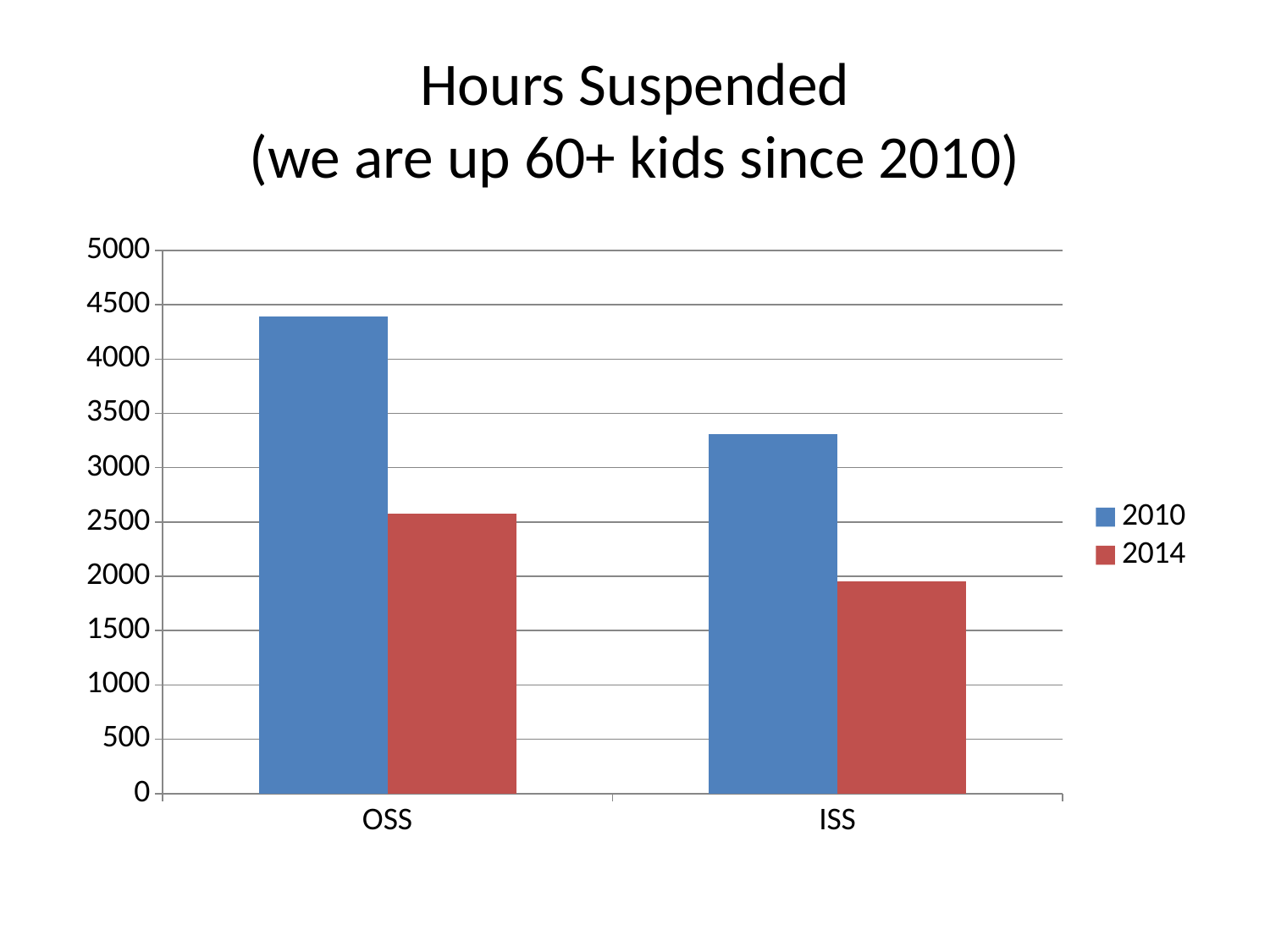
Which category has the larger 2014 value, OSS or ISS? OSS Is the 2014 value for ISS greater or less than 2500? less Which series and category has the highest bar? 2010, OSS What is the title of the chart? Hours Suspended (we are up 60+ kids since 2010) Which series and category has the lowest bar? 2014, ISS How many series does the legend list? 2 Is the 2014 value for OSS greater or less than 2000? greater Is the 2010 value for OSS greater or less than 4000? greater How many categories are shown on the x axis? 2 What kind of chart is shown on the slide? bar chart For OSS, which year has the larger value, 2010 or 2014? 2010